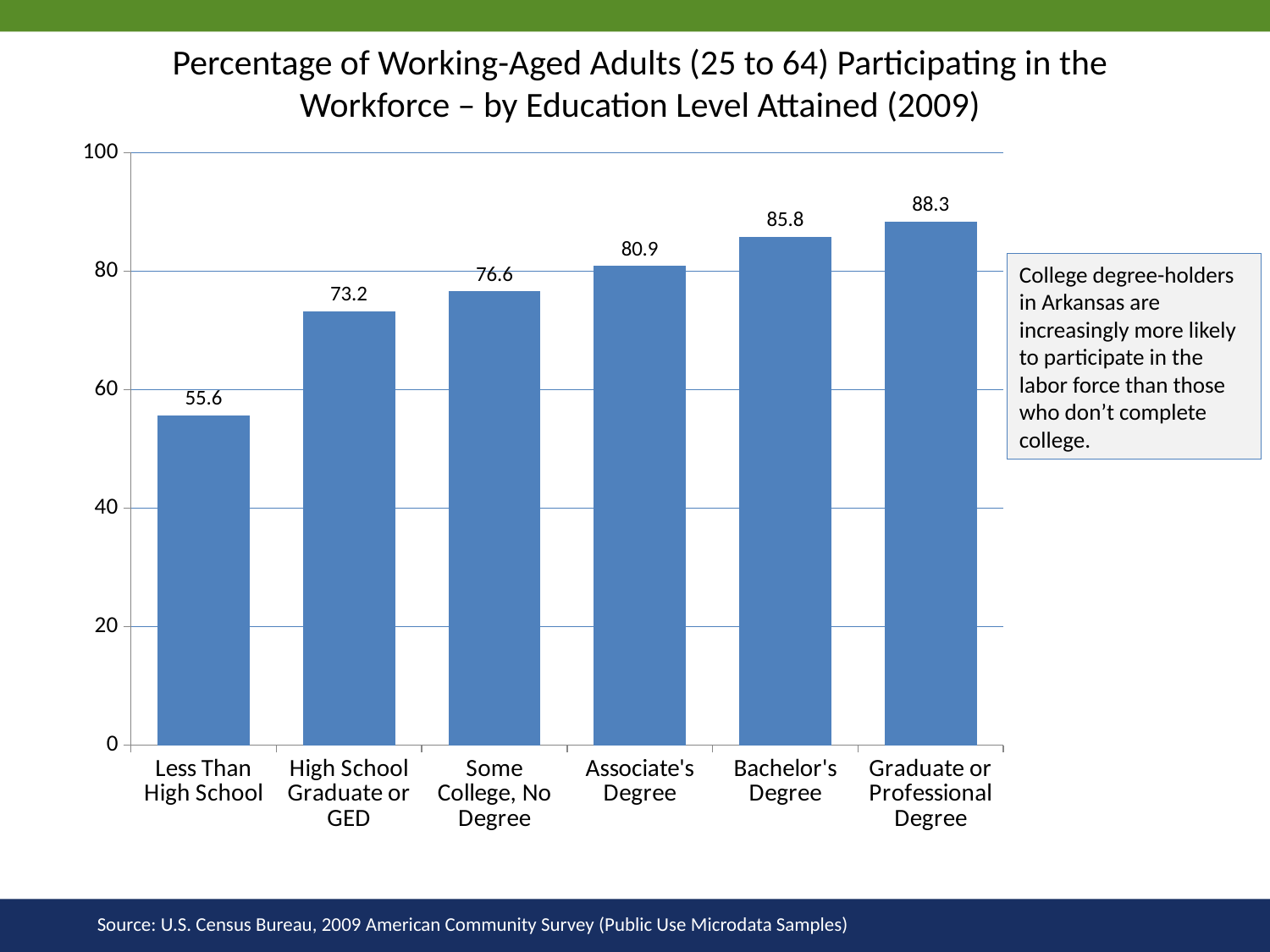
Which education level has the lowest workforce participation percentage? Less Than High School What is the value shown for Bachelor's Degree? 85.8 What is the workforce participation percentage for adults with Less Than High School education? 55.6 How many education level categories are shown on the chart? 6 What is the difference between the values for Associate's Degree and Some College, No Degree? 4.3 What is the value shown for High School Graduate or GED? 73.2 Which education level has the highest workforce participation percentage? Graduate or Professional Degree Do the values rise or fall as education level increases from left to right along the x axis? Rise Which is larger, the value for Bachelor's Degree or the value for Associate's Degree? Bachelor's Degree What is the value shown for Some College, No Degree? 76.6 What kind of chart is shown on the slide? Bar chart What is the difference between the values for Graduate or Professional Degree and Less Than High School? 32.7